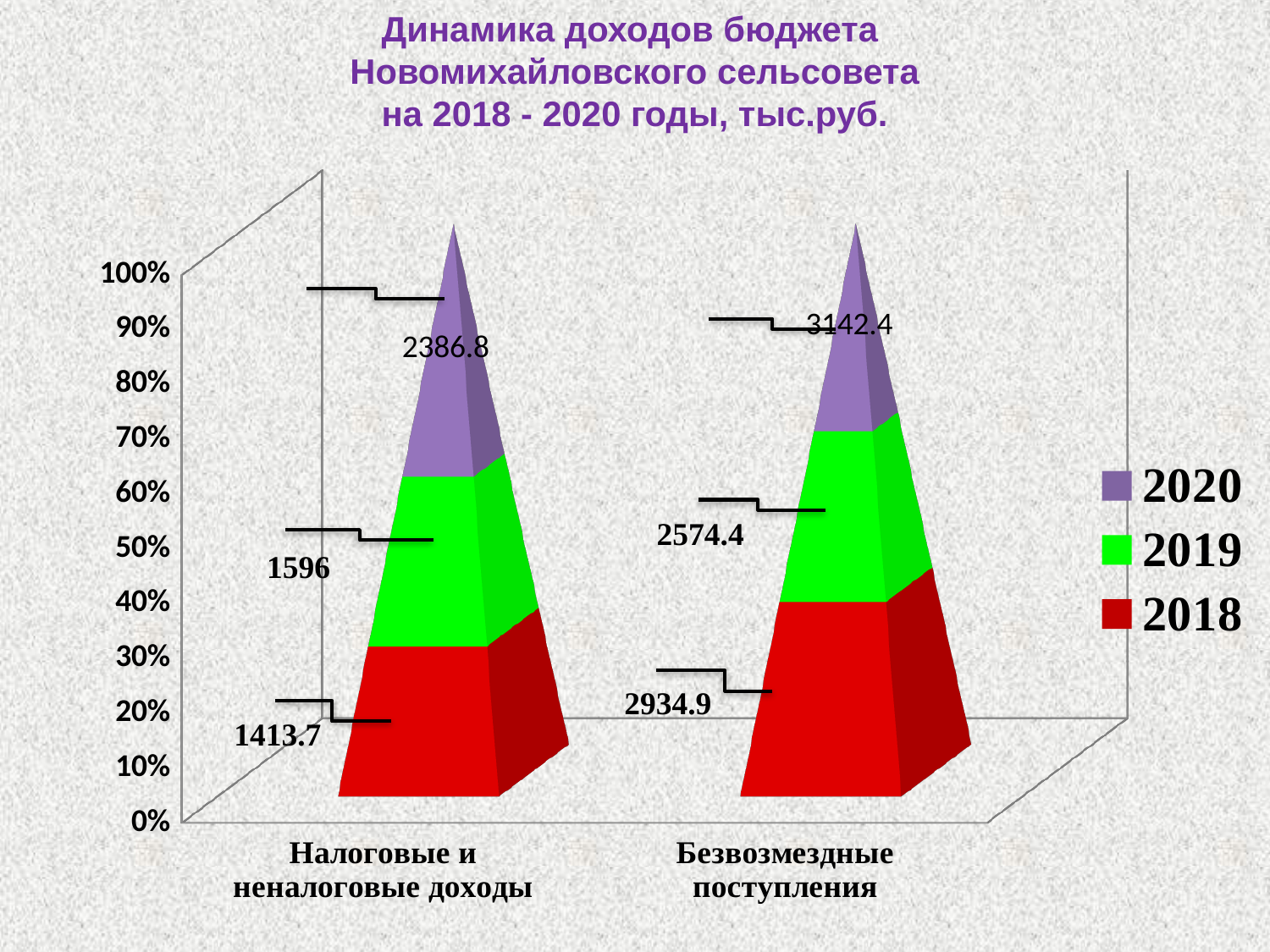
What is the value for 2020 in the "Налоговые и неналоговые доходы" category? 2386.8 What is the value for 2018 in the "Безвозмездные поступления" category? 2934.9 How many series does the legend list? 3 What is the value for 2019 in the "Налоговые и неналоговые доходы" category? 1596 Which year has the lowest value in the "Налоговые и неналоговые доходы" category? 2018 What is the value for 2019 in the "Безвозмездные поступления" category? 2574.4 What is the difference between the 2020 and 2018 values for "Налоговые и неналоговые доходы"? 973.1 Which year has the highest value in the "Безвозмездные поступления" category? 2020 Which category has the larger value for 2020: "Налоговые и неналоговые доходы" or "Безвозмездные поступления"? Безвозмездные поступления What is the total of the three values for "Налоговые и неналоговые доходы"? 5396.5 How many categories are shown on the x axis? 2 What kind of chart is shown on the slide? Stacked bar chart